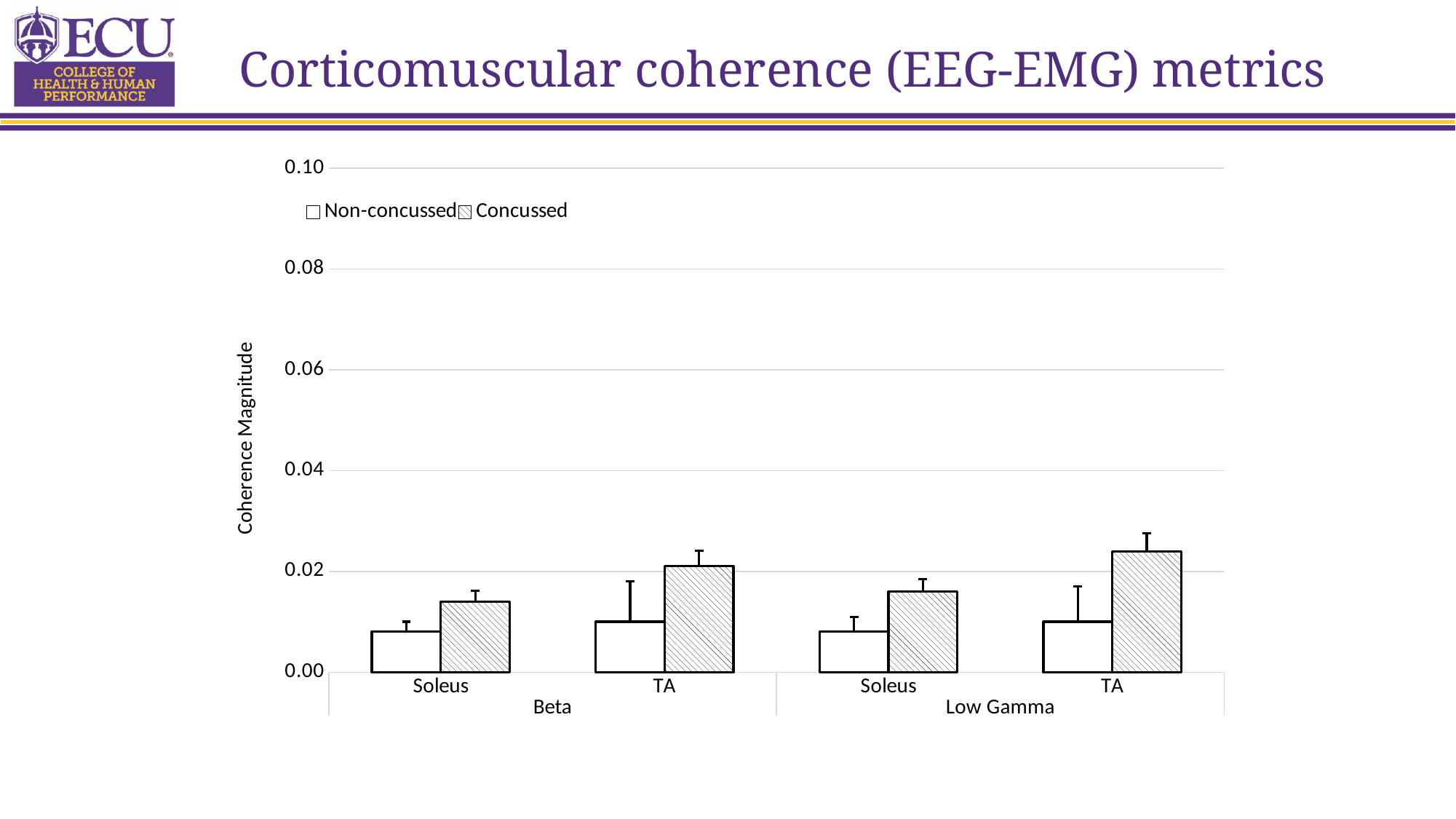
In the Beta TA group, which is larger: the Non-concussed bar or the Concussed bar? Concussed How many muscle categories (bar groups) are plotted along the x axis of the chart? 4 Is the Non-concussed value for TA in the Low Gamma band greater or less than 0.04? less Is the Concussed value for Soleus in the Beta band greater or less than 0.02? less In the Low Gamma Soleus group, which is larger: the Non-concussed bar or the Concussed bar? Concussed What are the two series named in the chart legend? Non-concussed and Concussed What kind of chart is shown on the slide? bar chart What is the label on the vertical axis of the chart? Coherence Magnitude Is the Non-concussed value for Soleus in the Beta band greater or less than 0.02? less How many series does the chart legend list? 2 Which bar in the chart is the highest overall? Concussed, TA (Low Gamma)